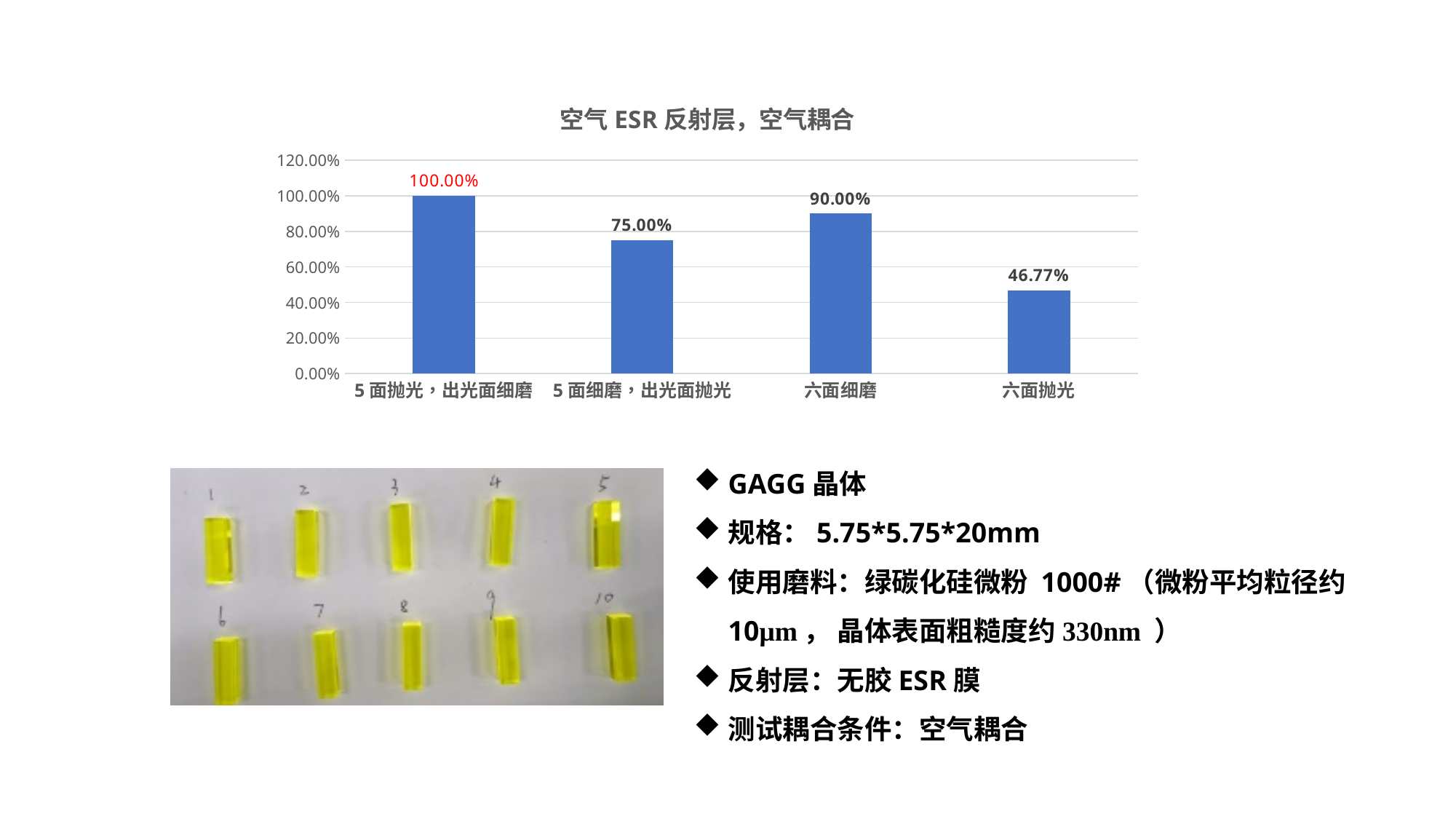
Which category has the lowest value? 六面抛光 How many categories are shown on the x axis? 4 What is the value for 5 面细磨，出光面抛光? 75.00% Is the value for 六面抛光 greater or less than 60.00%? less What is the value for 六面抛光? 46.77% What is the title of the chart? 空气 ESR 反射层，空气耦合 What is the difference between the values for 5 面抛光，出光面细磨 and 六面抛光? 53.23% What kind of chart is shown on the slide? bar chart Which category has the highest value? 5 面抛光，出光面细磨 What is the value for 六面细磨? 90.00% What is the difference between the values for 六面细磨 and 5 面细磨，出光面抛光? 15.00% Which is larger, the value for 六面细磨 or the value for 5 面细磨，出光面抛光? 六面细磨